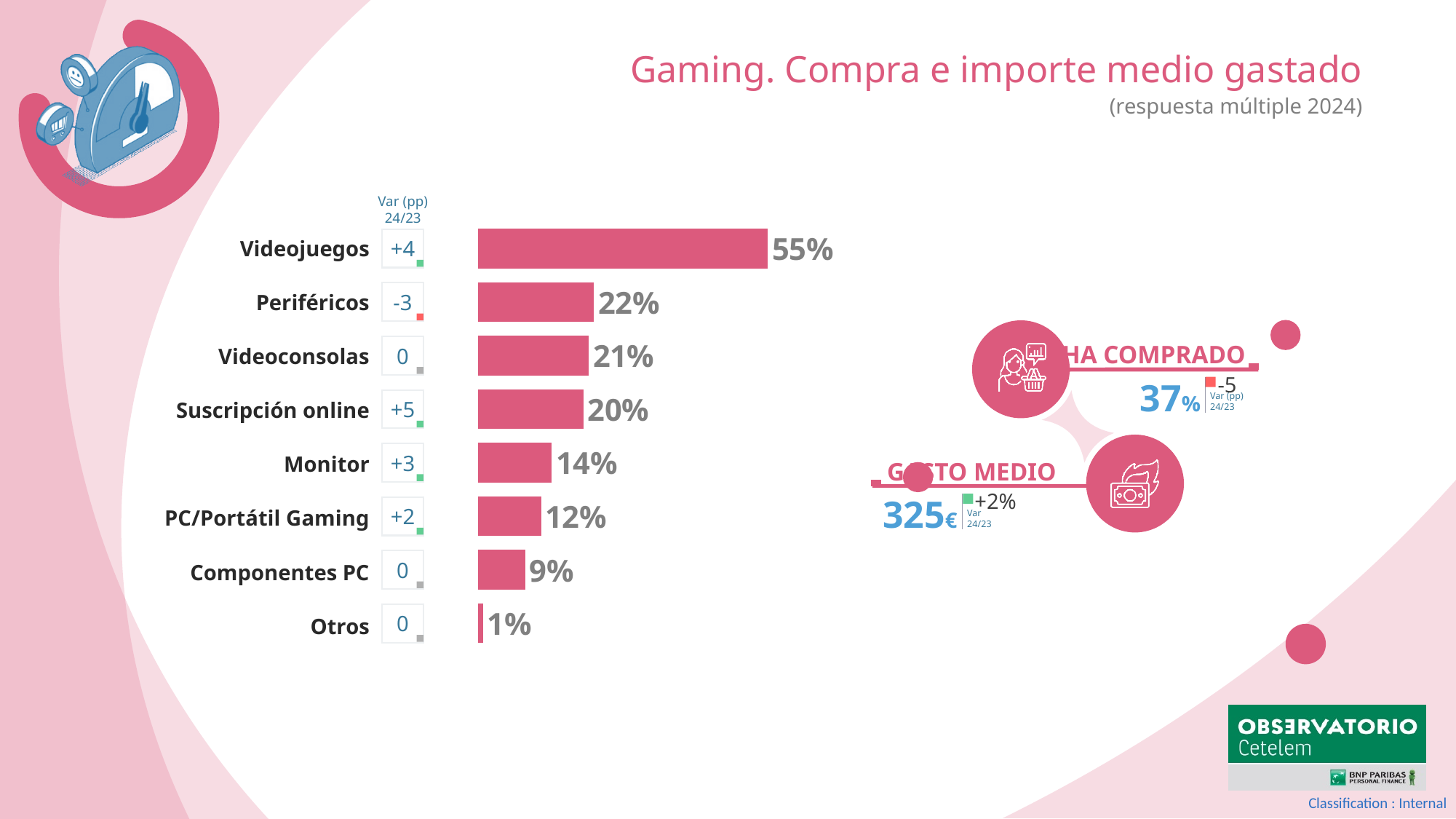
What percentage is shown for Suscripción online? 20% How many categories are shown in the bar chart? 8 What is the title of the slide? Gaming. Compra e importe medio gastado What is the Var (pp) 24/23 value shown for Periféricos? -3 What is the difference in percentage points between Videojuegos and Periféricos? 33 Which has a higher percentage, Monitor or PC/Portátil Gaming? Monitor What percentage is shown for Videojuegos? 55% Which category has the lowest percentage? Otros What percentage is shown for Componentes PC? 9% Which category has the highest percentage? Videojuegos What kind of chart is used to show the purchase percentages? Bar chart What is the Var (pp) 24/23 value shown for Suscripción online? +5